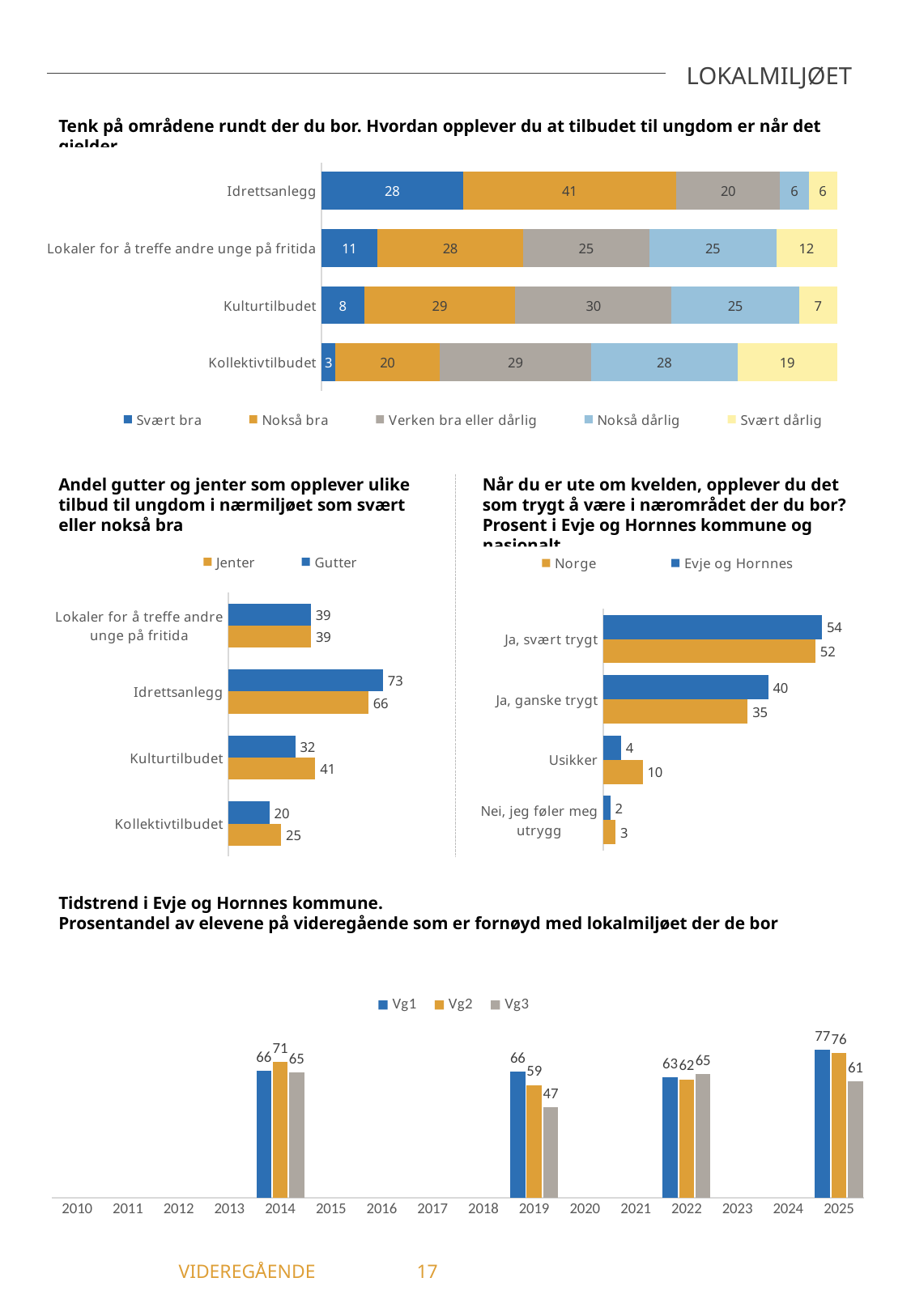
What kind of chart is the chart "Tidstrend i Evje og Hornnes kommune"? Bar chart In the chart "Andel gutter og jenter som opplever ulike tilbud til ungdom i nærmiljøet som svært eller nokså bra", what is the difference between Jenter and Gutter for Kulturtilbudet? 9 In the chart "Tidstrend i Evje og Hornnes kommune", which year has the highest Vg1 value? 2025 In the top stacked bar chart ("Tenk på områdene rundt der du bor..."), what is the value for "Nokså bra" for Idrettsanlegg? 41 In the chart "Når du er ute om kvelden, opplever du det som trygt å være i nærområdet der du bor?", what is the value for Norge for "Usikker"? 10 In the top stacked bar chart ("Tenk på områdene rundt der du bor..."), which category has the highest "Svært bra" value? Idrettsanlegg In the chart "Andel gutter og jenter som opplever ulike tilbud til ungdom i nærmiljøet som svært eller nokså bra", what is the value for Gutter for Idrettsanlegg? 73 In the chart "Andel gutter og jenter som opplever ulike tilbud til ungdom i nærmiljøet som svært eller nokså bra", which category has the lowest Jenter value? Kollektivtilbudet In the top stacked bar chart ("Tenk på områdene rundt der du bor..."), how many series does the legend list? 5 In the top stacked bar chart ("Tenk på områdene rundt der du bor..."), what is the value for "Svært dårlig" for Kollektivtilbudet? 19 In the chart "Tidstrend i Evje og Hornnes kommune", what is the value for Vg3 in 2019? 47 In the chart "Når du er ute om kvelden, opplever du det som trygt å være i nærområdet der du bor?", which is larger for "Ja, ganske trygt": Norge or Evje og Hornnes? Evje og Hornnes